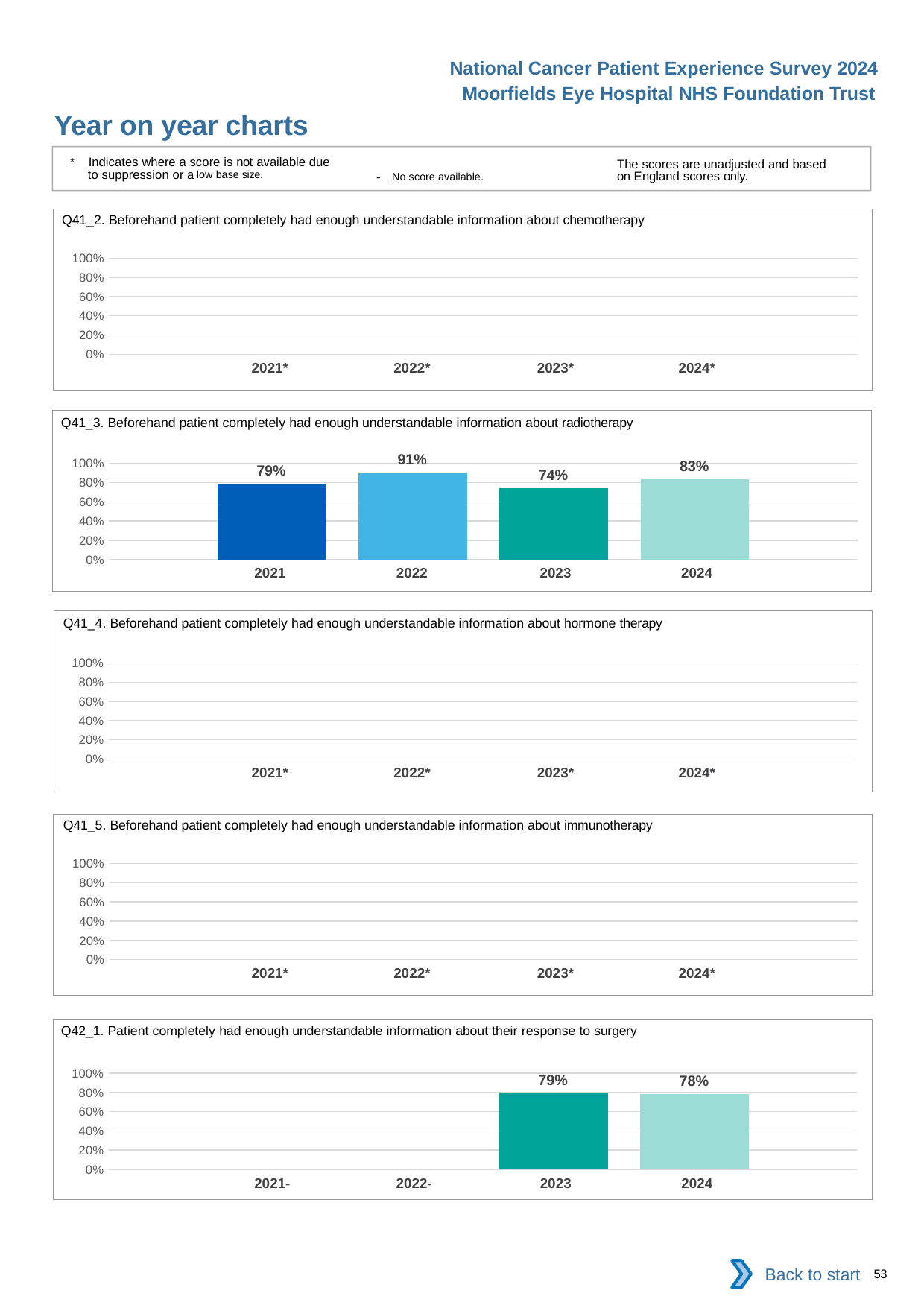
In the Q42_1 surgery chart, what is the difference between the 2023 and 2024 values? 1% How many charts on the slide show no plotted bars at all? 3 In the Q41_3 radiotherapy chart, what is the difference between the 2022 and 2021 values? 12% In the Q42_1 surgery chart, what is the value for 2024? 78% In the Q41_3 radiotherapy chart, what is the value for 2022? 91% In the Q41_3 radiotherapy chart, which year has the lowest value? 2023 In the Q42_1 surgery chart, what is the value for 2023? 79% What kind of chart is the Q41_3 radiotherapy chart? Bar chart In the Q41_3 radiotherapy chart, what is the value for 2023? 74% In the Q41_3 radiotherapy chart, which year has the highest value? 2022 In the Q41_3 radiotherapy chart, which is larger, the value for 2024 or the value for 2021? 2024 In the Q41_3 radiotherapy chart, how many years are shown on the x axis? 4